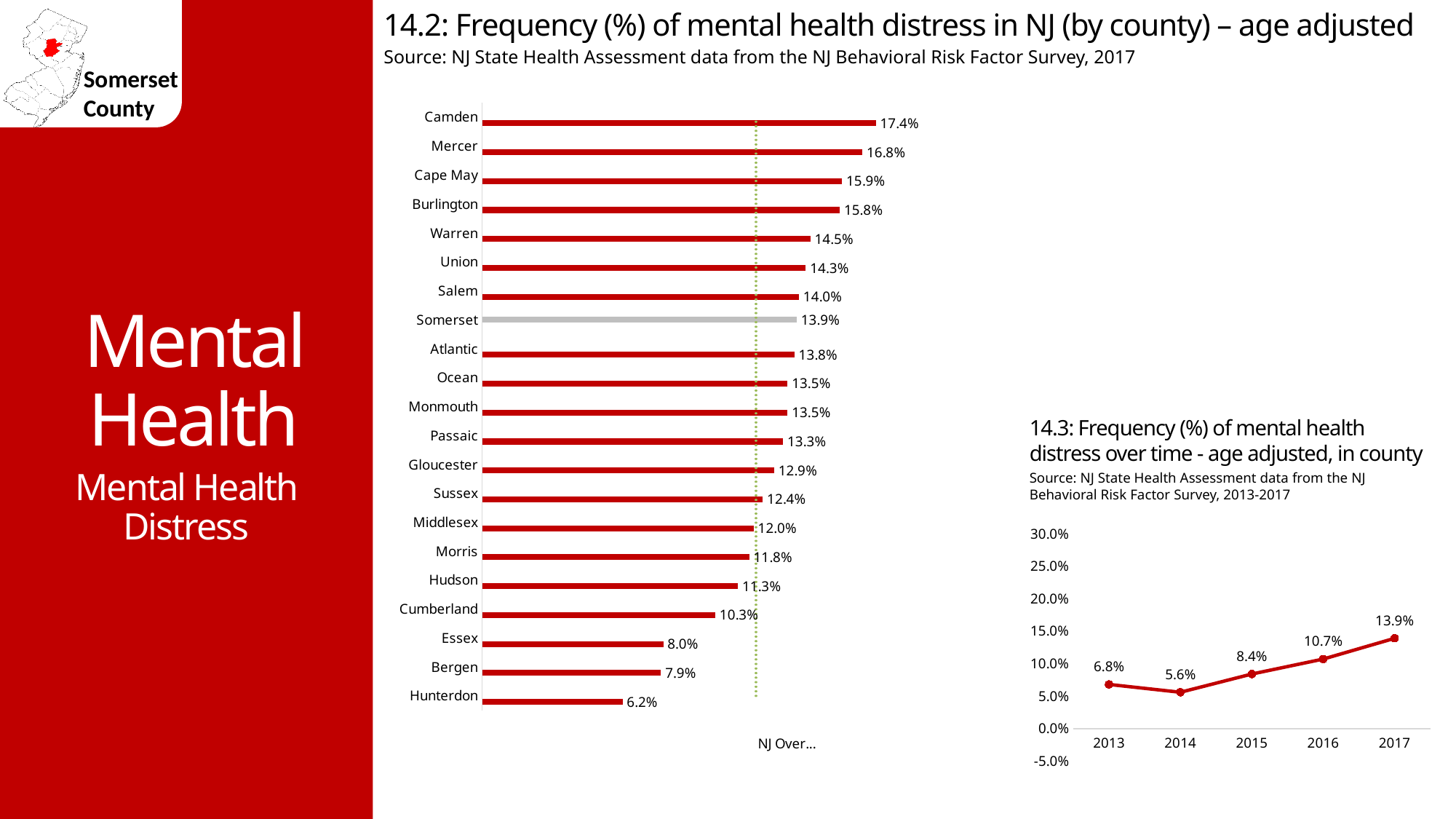
In chart 14.2, what is the difference between the values for Camden and Hunterdon? 11.2% In chart 14.2, which county has the highest value? Camden In chart 14.2, how many counties are plotted? 21 In chart 14.3, what is the value for 2014? 5.6% In chart 14.2, what is the value for Somerset? 13.9% In chart 14.3, which year has the highest value? 2017 In chart 14.3, what is the difference between the values for 2017 and 2016? 3.2% In chart 14.3, how many years are plotted? 5 In chart 14.2, which is larger, the value for Warren or the value for Union? Warren In chart 14.2, which county has the lowest value? Hunterdon In chart 14.2, what is the value for Bergen? 7.9% What kind of chart is chart 14.2? Bar chart